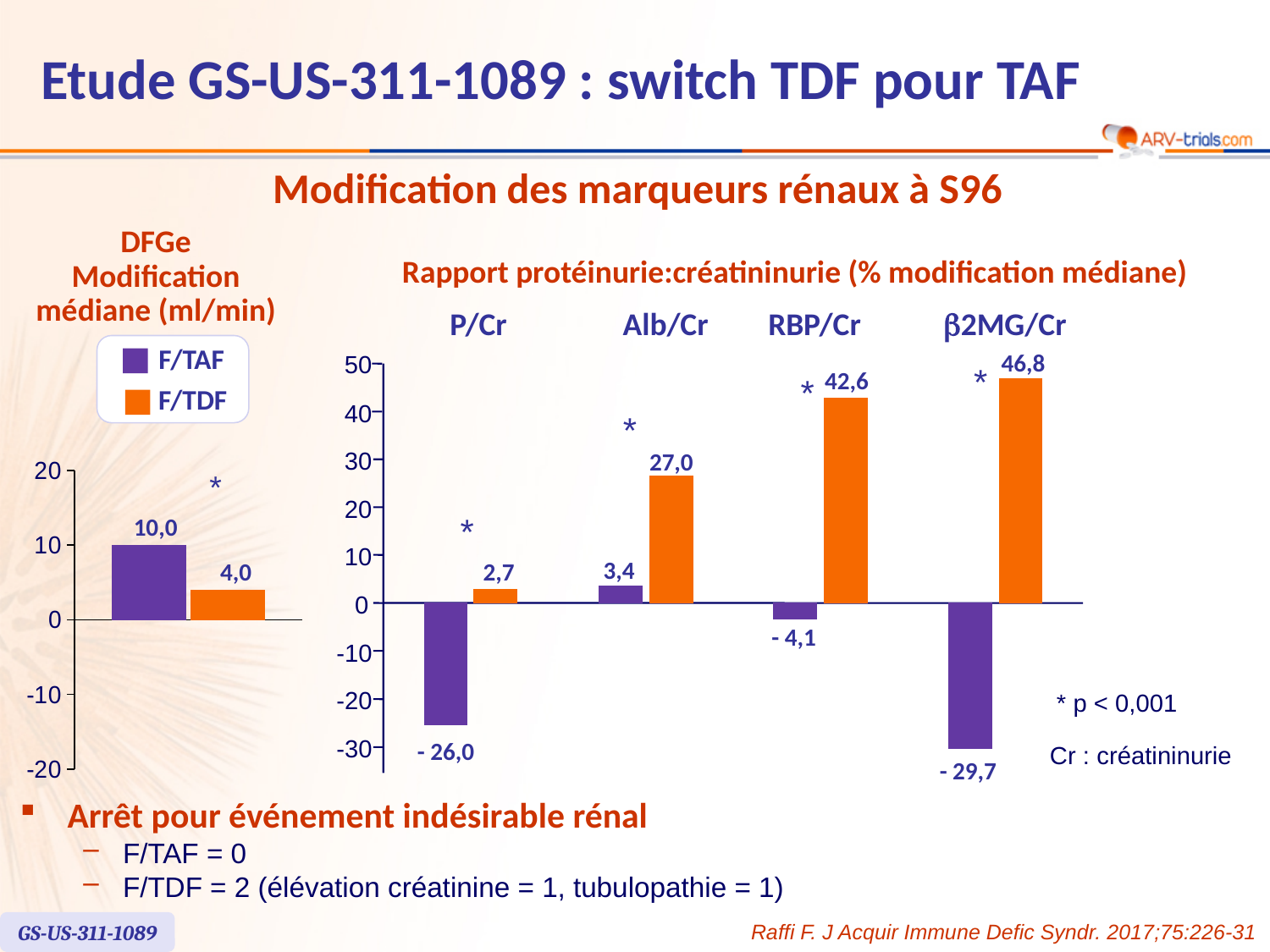
In the 'Rapport protéinurie:créatininurie' chart, which category has the highest F/TDF value? β2MG/Cr In the 'Rapport protéinurie:créatininurie' chart, what is the difference between the F/TDF and F/TAF values for Alb/Cr? 23,6 In the DFGe chart on the left, what is the median change for F/TAF? 10,0 How many series does the legend list? 2 In the 'Rapport protéinurie:créatininurie' chart, which is larger for Alb/Cr: the F/TAF value or the F/TDF value? F/TDF How many categories are shown in the 'Rapport protéinurie:créatininurie' chart? 4 In the DFGe chart on the left, what is the median change for F/TDF? 4,0 In the 'Rapport protéinurie:créatininurie' chart, what is the F/TDF value for β2MG/Cr? 46,8 In the 'Rapport protéinurie:créatininurie' chart, which category has the lowest F/TAF value? β2MG/Cr In the 'Rapport protéinurie:créatininurie' chart, what is the F/TAF value for RBP/Cr? - 4,1 In the 'Rapport protéinurie:créatininurie' chart, what is the F/TAF value for P/Cr? - 26,0 In the DFGe chart on the left, what is the difference between the F/TAF and F/TDF values? 6,0